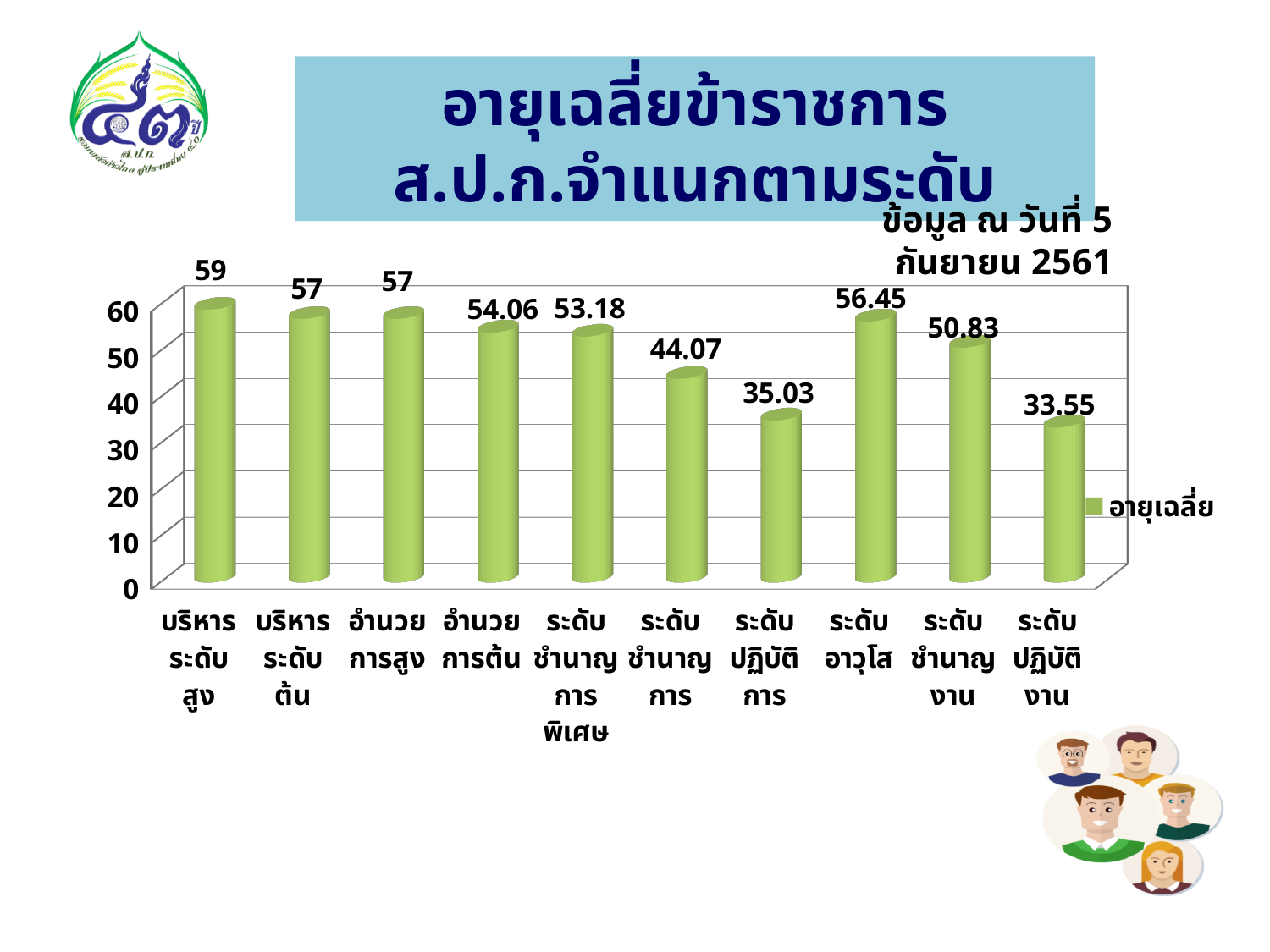
Which category has the lowest average age? ระดับปฏิบัติงาน How many series does the legend list? 1 What is the difference between the values for ระดับชำนาญการ and ระดับปฏิบัติการ? 9.04 Which category has the highest average age? บริหารระดับสูง How many categories are shown on the x axis? 10 What kind of chart is shown on the slide? bar chart Which is larger, the value for อำนวยการต้น or the value for ระดับชำนาญงาน? อำนวยการต้น What is the value shown for ระดับชำนาญการพิเศษ? 53.18 What is the average age for บริหารระดับสูง? 59 What is the value shown for ระดับอาวุโส? 56.45 What is the value shown for ระดับปฏิบัติการ? 35.03 Is the value for ระดับปฏิบัติงาน greater or less than 40? less